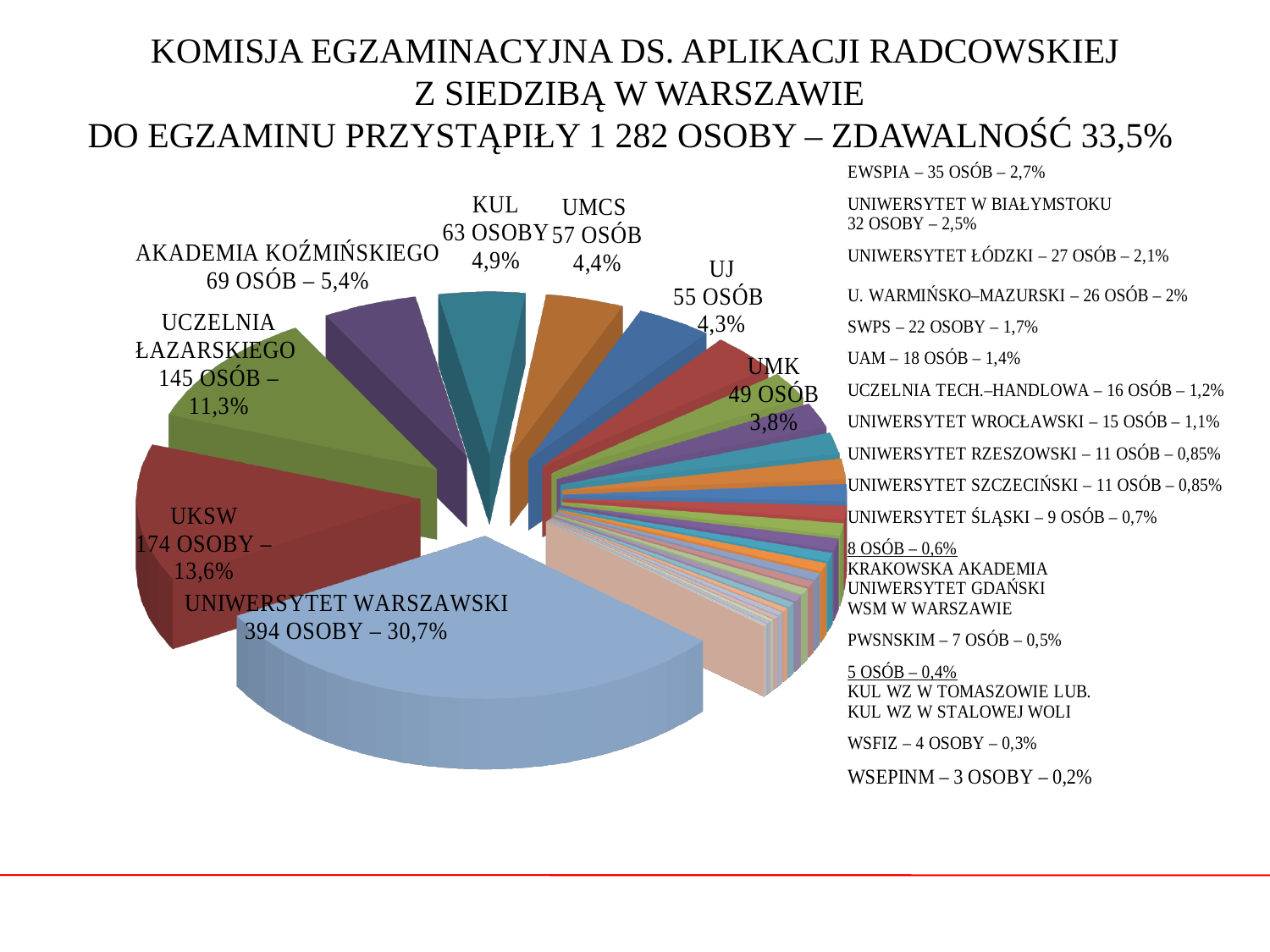
Which has more people, UKSW or Uczelnia Łazarskiego? UKSW How many people are shown for KUL? 63 osoby What is the difference in the number of people between Uniwersytet Warszawski and UKSW? 220 How many people are shown for Uniwersytet Warszawski? 394 osoby What share of the pie does Uniwersytet Warszawski represent? 30,7% What kind of chart is shown on the slide? pie chart What pass rate (zdawalność) is stated in the chart title? 33,5% What percentage is shown for UMK? 3,8% What percentage is shown for Uczelnia Łazarskiego? 11,3% How many people are shown for UKSW? 174 osoby Which university has the largest slice of the pie? Uniwersytet Warszawski